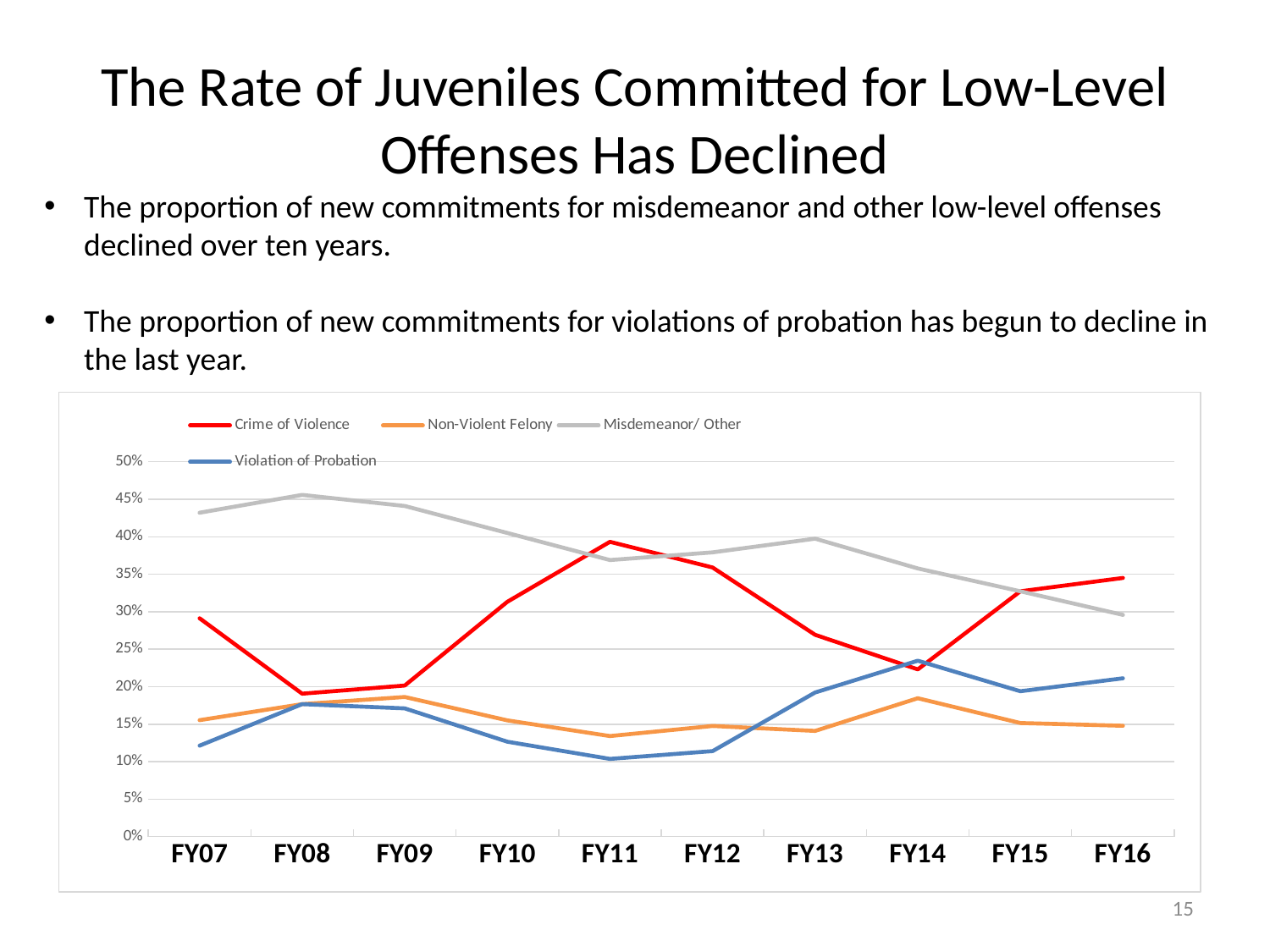
Is the value for Violation of Probation in FY07 greater or less than 15%? less In which fiscal year does the Crime of Violence line reach its highest point? FY11 Does the Misdemeanor/ Other line rise or fall from FY13 to FY16? Fall What kind of chart is shown on the slide? Line chart How many fiscal years are plotted along the x axis? 10 Is the value for Crime of Violence in FY11 greater or less than 35%? greater In which fiscal year is the Violation of Probation line at its lowest? FY11 In FY16, which is higher: Crime of Violence or Misdemeanor/ Other? Crime of Violence How many series does the chart's legend list? 4 In which fiscal year does the Misdemeanor/ Other line reach its highest point? FY08 In FY13, which is higher: Violation of Probation or Non-Violent Felony? Violation of Probation Is the value for Misdemeanor/ Other in FY07 greater or less than 40%? greater